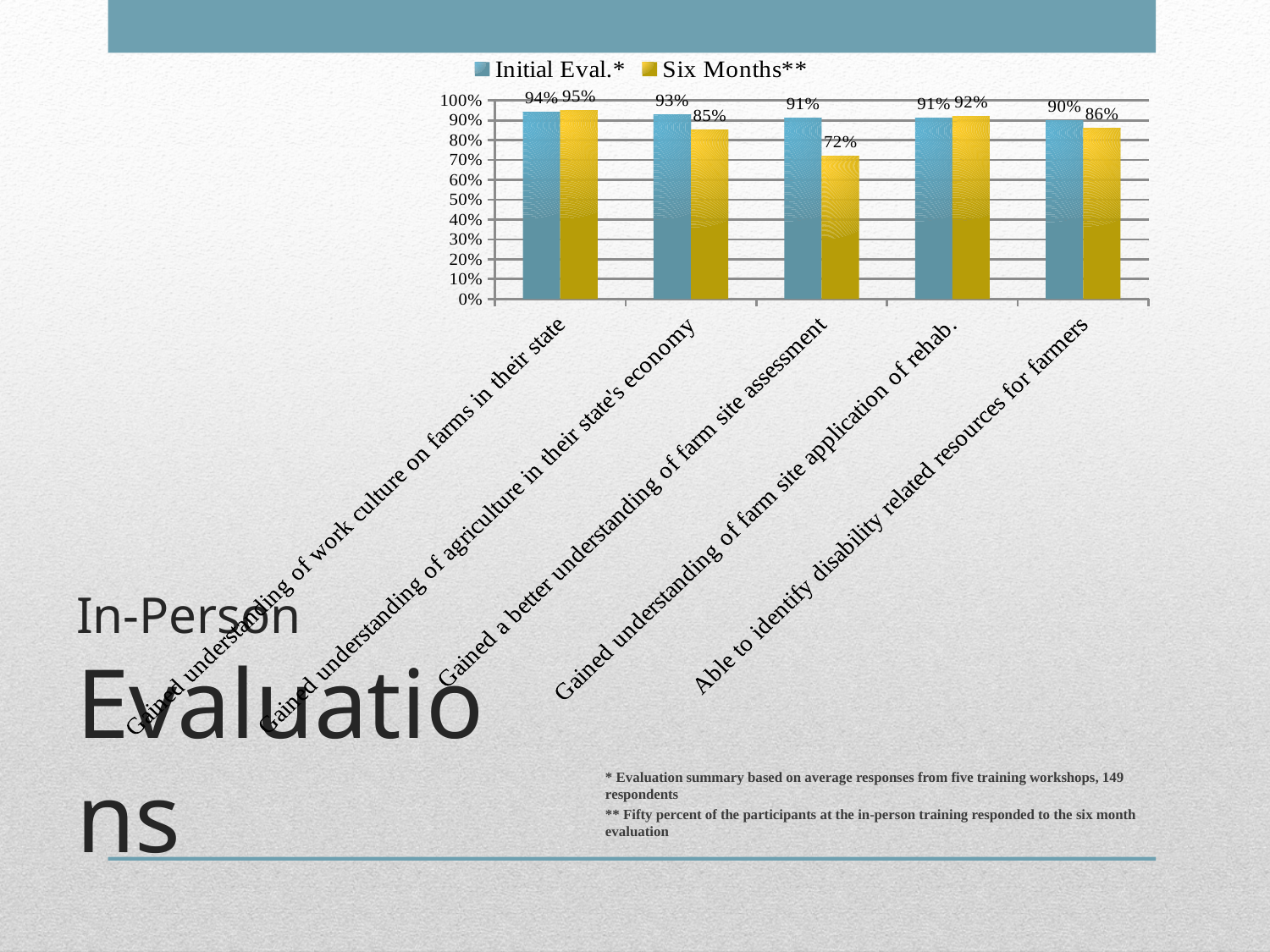
What kind of chart is shown on the slide? bar chart What are the two legend entries of the chart? Initial Eval.* and Six Months** How many categories are shown on the x axis? 5 What is the Six Months** value for 'Able to identify disability related resources for farmers'? 86% Which category has the highest Six Months** value? Gained understanding of work culture on farms in their state For 'Gained understanding of farm site application of rehab.', which is larger: the Initial Eval.* value or the Six Months** value? Six Months** How many series does the legend list? 2 What is the difference between the Initial Eval.* and Six Months** values for 'Gained understanding of agriculture in their state's economy'? 8% What is the Six Months** value for 'Gained a better understanding of farm site assessment'? 72% What is the Initial Eval.* value for 'Gained understanding of agriculture in their state's economy'? 93% What is the difference between the Initial Eval.* and Six Months** values for 'Gained a better understanding of farm site assessment'? 19% Which category has the lowest Six Months** value? Gained a better understanding of farm site assessment